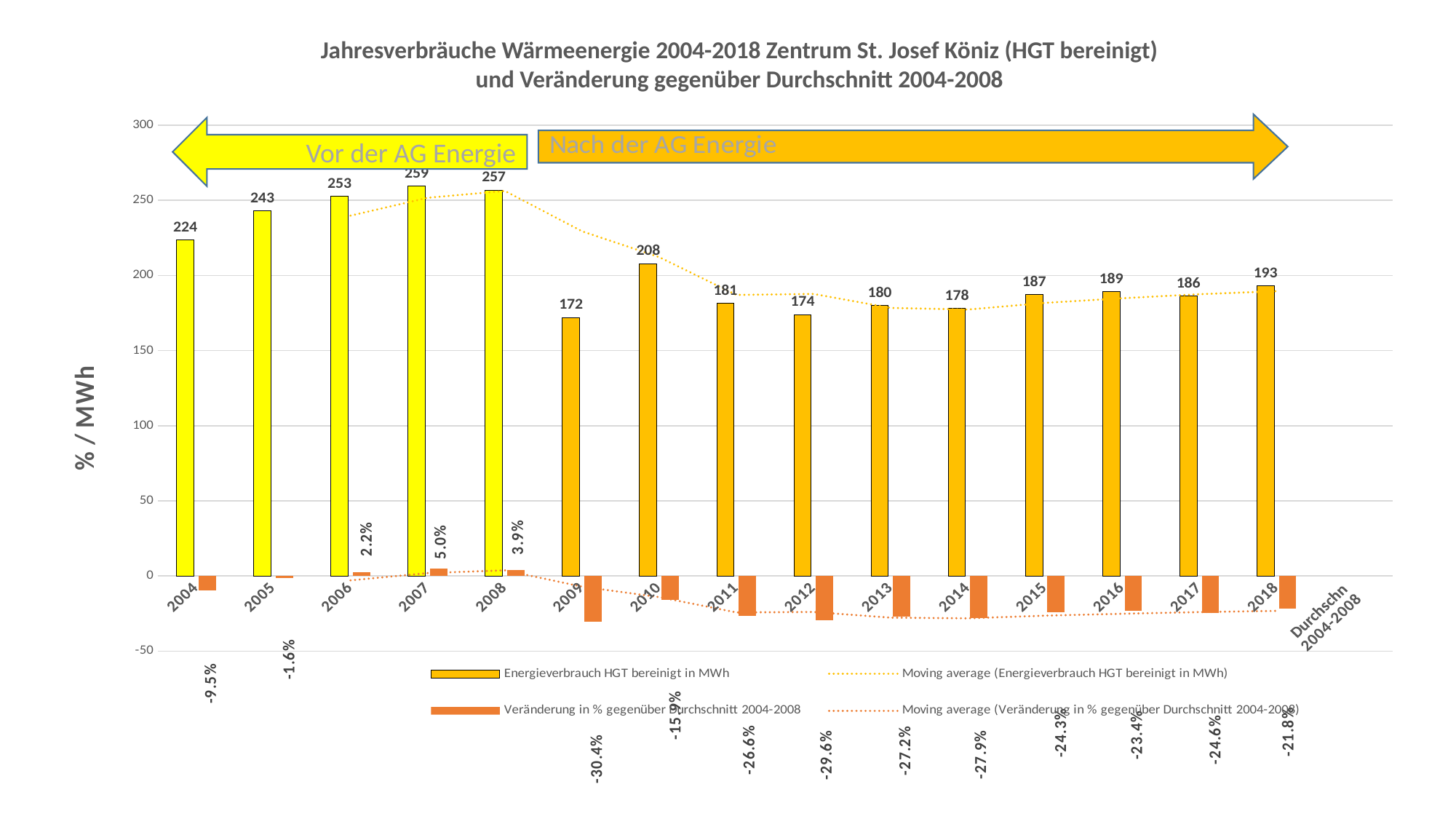
What is the Veränderung in % gegenüber Durchschnitt 2004-2008 for 2007? 5.0% Does the Energieverbrauch value rise or fall from 2004 to 2007? rise Which year has the highest Energieverbrauch HGT bereinigt in MWh? 2007 What is the Energieverbrauch HGT bereinigt in MWh value for 2018? 193 What is the Energieverbrauch HGT bereinigt in MWh value for 2004? 224 Which year has the lowest Energieverbrauch HGT bereinigt in MWh? 2009 Which year has the lowest Veränderung in % gegenüber Durchschnitt 2004-2008? 2009 What is the label on the vertical axis? % / MWh How many series does the legend list? 4 What is the Veränderung in % gegenüber Durchschnitt 2004-2008 for 2009? -30.4% What is the difference between the Energieverbrauch values for 2008 and 2009? 85 Which year has the larger Energieverbrauch value, 2010 or 2011? 2010